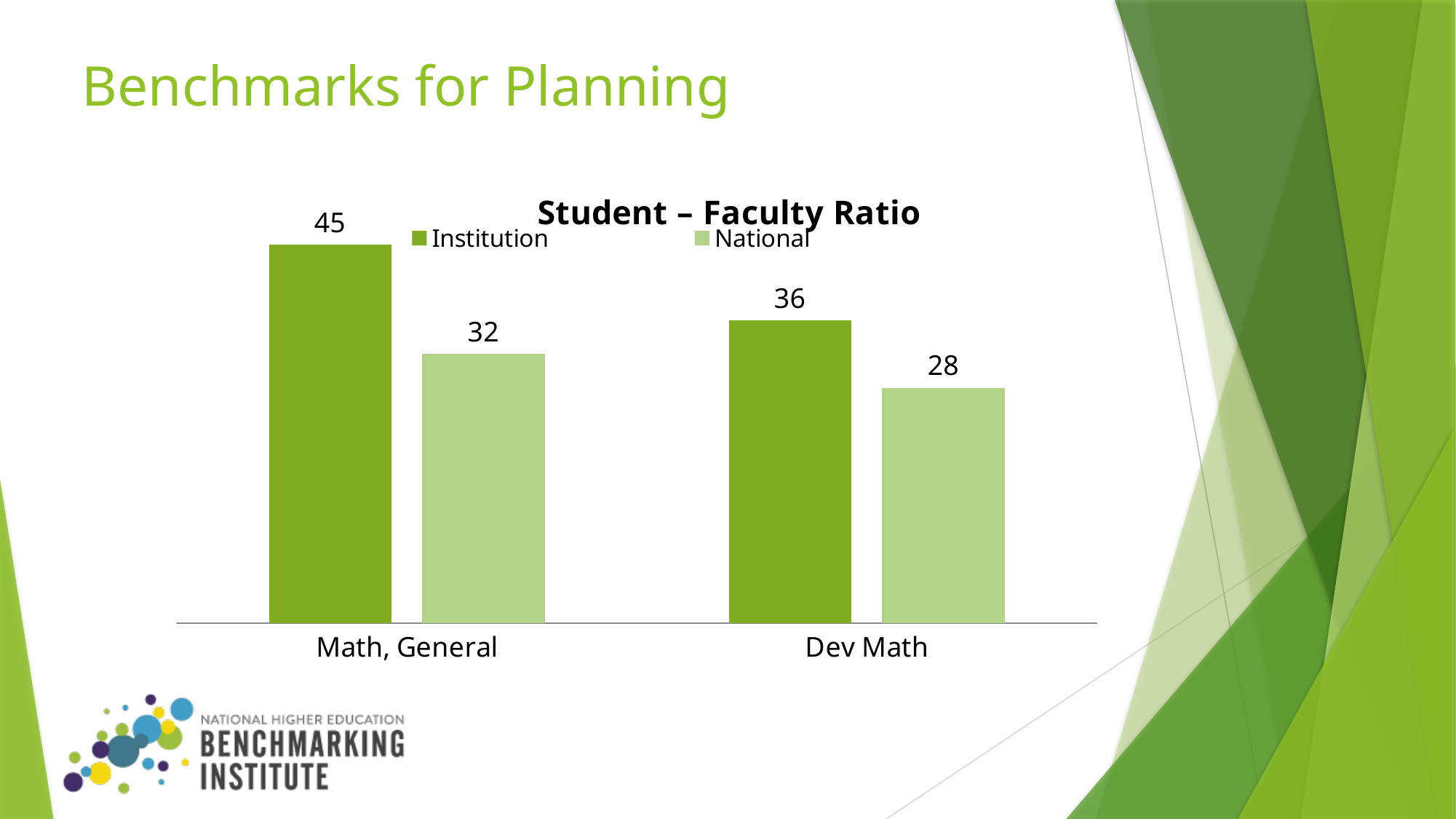
What is the Institution value for Math, General? 45 How many categories are shown on the x axis? 2 What is the difference between the Institution and National values for Math, General? 13 What is the Institution value for Dev Math? 36 Which is larger, the Institution value for Dev Math or the National value for Math, General? Institution value for Dev Math What is the difference between the Institution and National values for Dev Math? 8 How many series does the legend list? 2 What is the National value for Math, General? 32 Which category has the highest Institution value? Math, General What type of chart is shown on the slide? Bar chart What is the National value for Dev Math? 28 Which category has the lowest National value? Dev Math